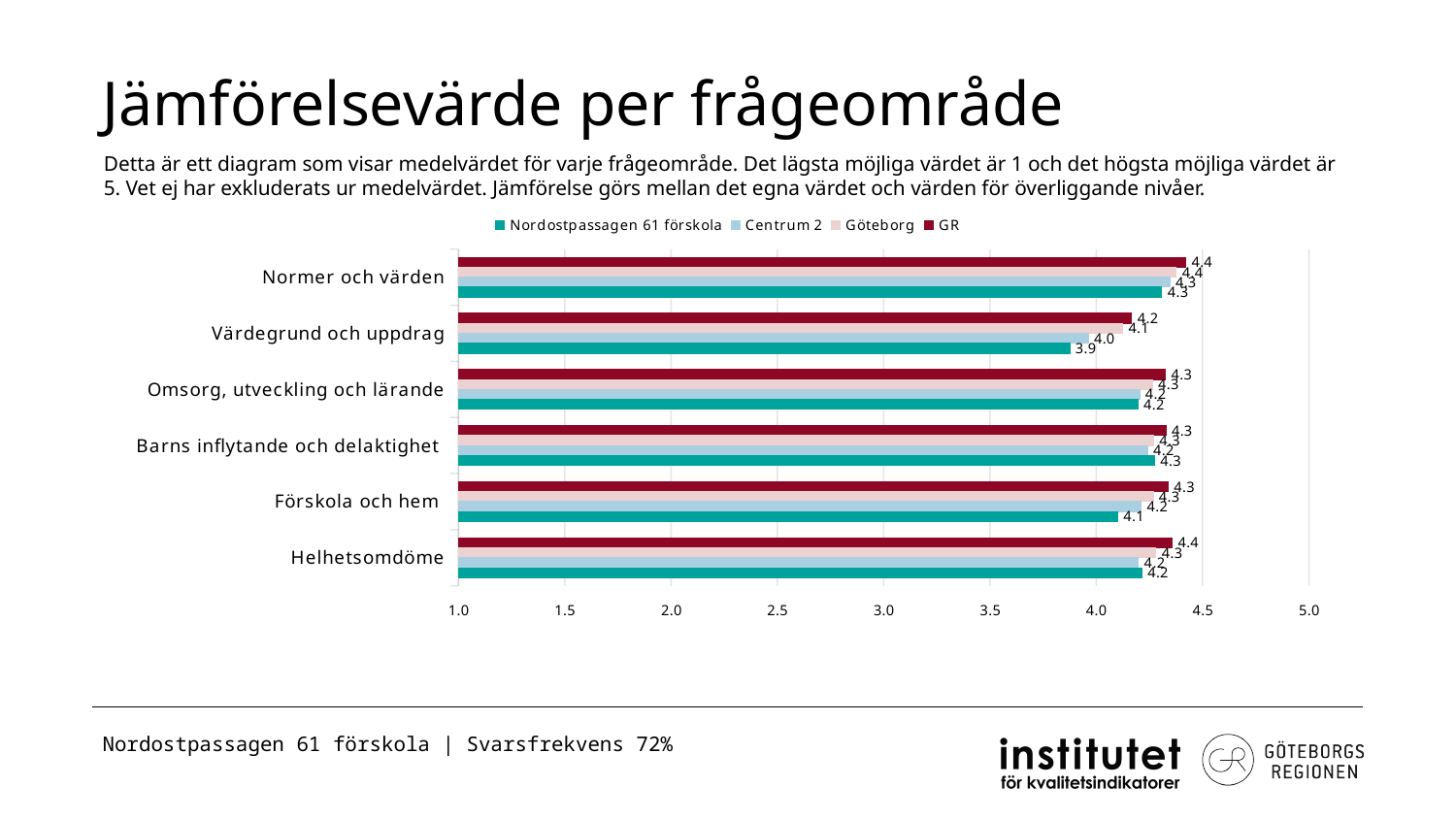
Which series is shown in dark red in the legend? GR How many series does the legend list? 4 What kind of chart is shown on the slide? Bar chart What is the value for Centrum 2 in the category Värdegrund och uppdrag? 4.0 In the category Förskola och hem, which is larger: the value for GR or the value for Nordostpassagen 61 förskola? GR What is the value for Nordostpassagen 61 förskola in the category Förskola och hem? 4.1 What is the value for GR in the category Helhetsomdöme? 4.4 What is the value for Nordostpassagen 61 förskola in the category Värdegrund och uppdrag? 3.9 How many categories (frågeområden) are shown on the chart? 6 Which category has the lowest value for Nordostpassagen 61 förskola? Värdegrund och uppdrag What is the difference between the GR value and the Nordostpassagen 61 förskola value in the category Värdegrund och uppdrag? 0.3 Is the value for Nordostpassagen 61 förskola in Värdegrund och uppdrag greater or less than 4.0? less